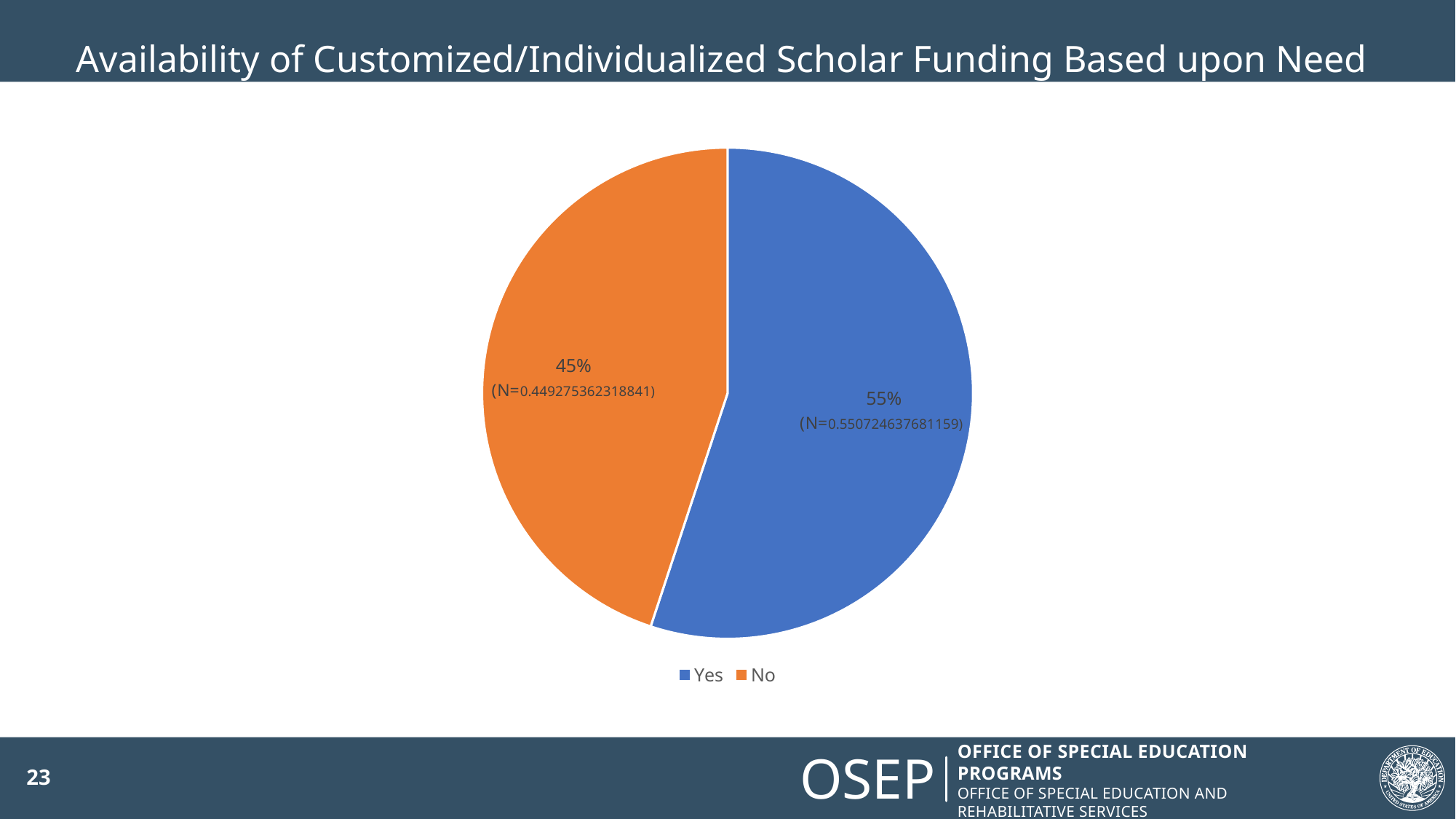
What kind of chart is shown on the slide? pie chart What colour is the "No" slice? orange What percentage of the pie is labelled "No"? 45% Which slice is larger, Yes or No? Yes Which slice is the largest? Yes What percentage of the pie is labelled "Yes"? 55% How many entries does the legend list? 2 Is the share for Yes greater or less than 50%? greater Which slice is the smallest? No What is the difference in percentage points between the Yes and No slices? 10 How many slices does the pie chart have? 2 What is the title of the slide? Availability of Customized/Individualized Scholar Funding Based upon Need